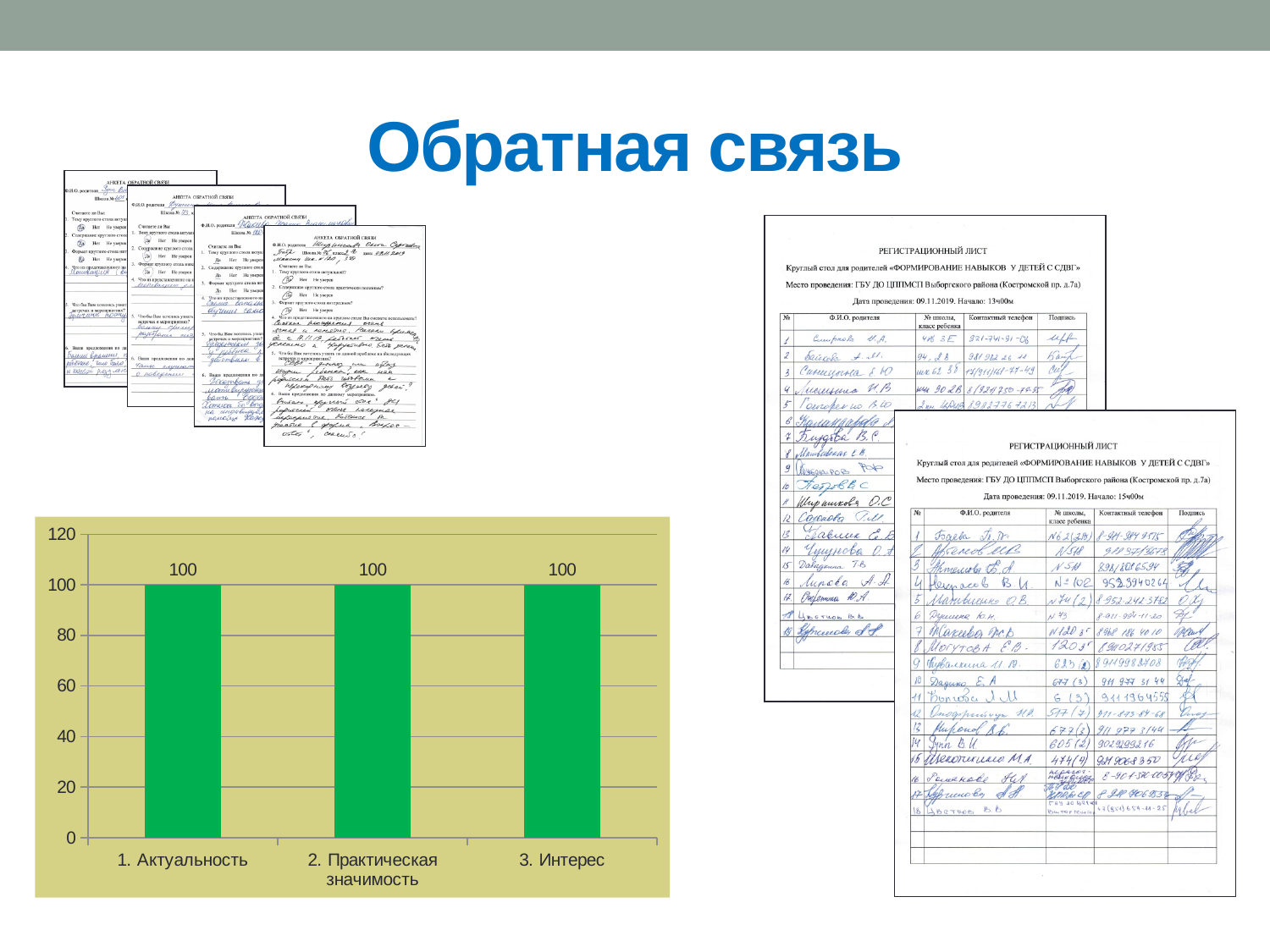
What kind of chart is shown on the slide? bar chart Is the value for "3. Интерес" greater or less than 120? less What is the value for "2. Практическая значимость" in the bar chart? 100 What colour are the bars in the chart? green Do the values rise, fall, or stay the same across the categories from left to right? stay the same How many categories are shown on the x axis of the bar chart? 3 What is the value for "3. Интерес" in the bar chart? 100 What is the highest value shown on the y axis of the bar chart? 120 Is the value for "1. Актуальность" greater or less than 80? greater What is the value for "1. Актуальность" in the bar chart? 100 What is the difference between the values for "1. Актуальность" and "3. Интерес"? 0